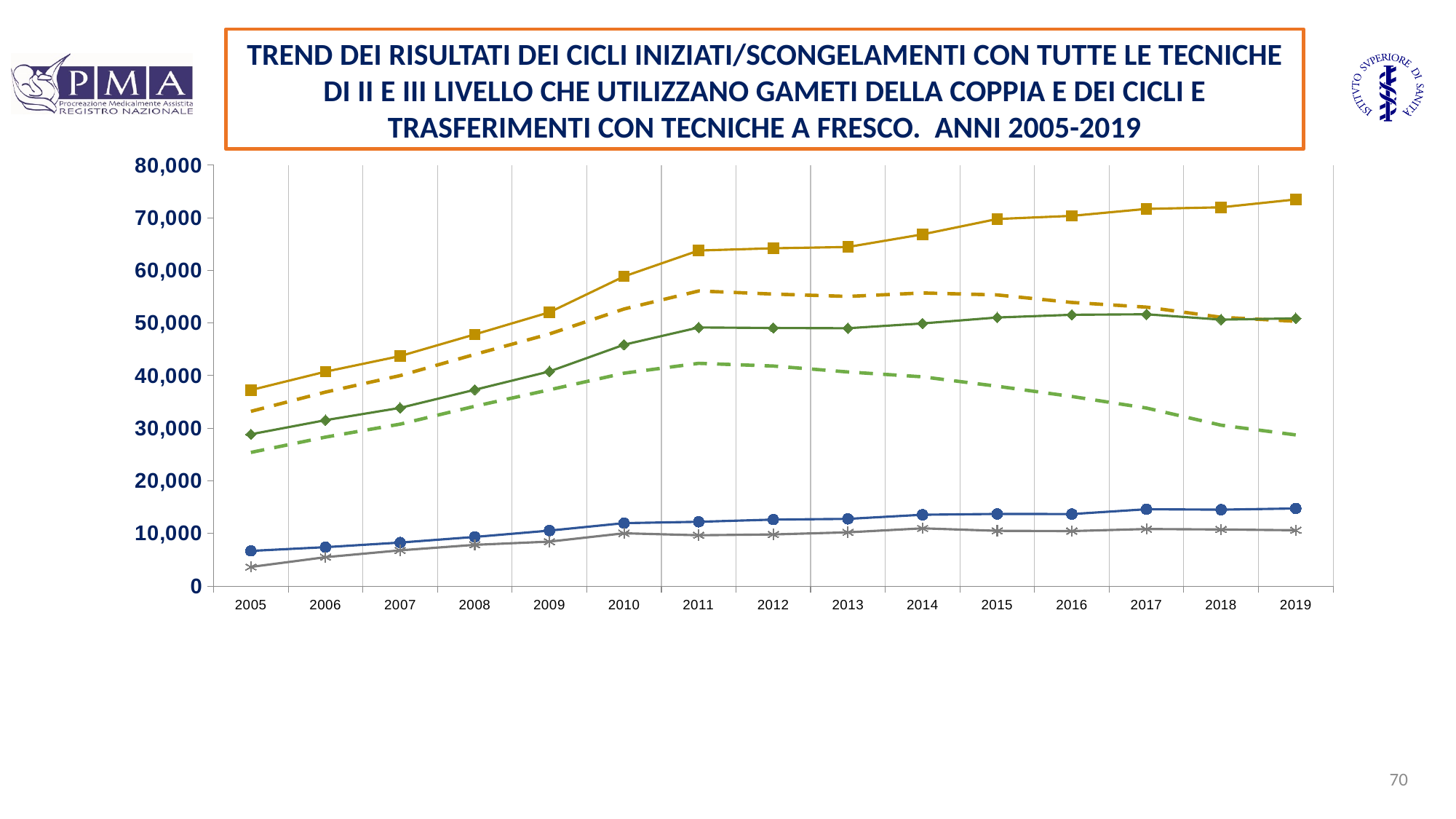
How many years are shown along the x axis of the chart? 15 In which year does the yellow line with square markers reach its highest value? 2019 Is the value of the grey line with asterisk markers in 2005 greater or less than 10,000? less In which year does the yellow line with square markers have its lowest value? 2005 How many lines are plotted on the chart? 6 Is the value of the yellow line with square markers in 2019 greater or less than 70,000? greater Is the value of the yellow line with square markers in 2005 greater or less than 40,000? less What is the highest value shown on the y axis of the chart? 80,000 Does the light green dashed line rise or fall from 2011 to 2019? fall What kind of chart is shown on the slide? line chart In 2019, which is larger: the yellow line with square markers or the green line with diamond markers? the yellow line with square markers Does the yellow line with square markers rise or fall from 2005 to 2019? rise